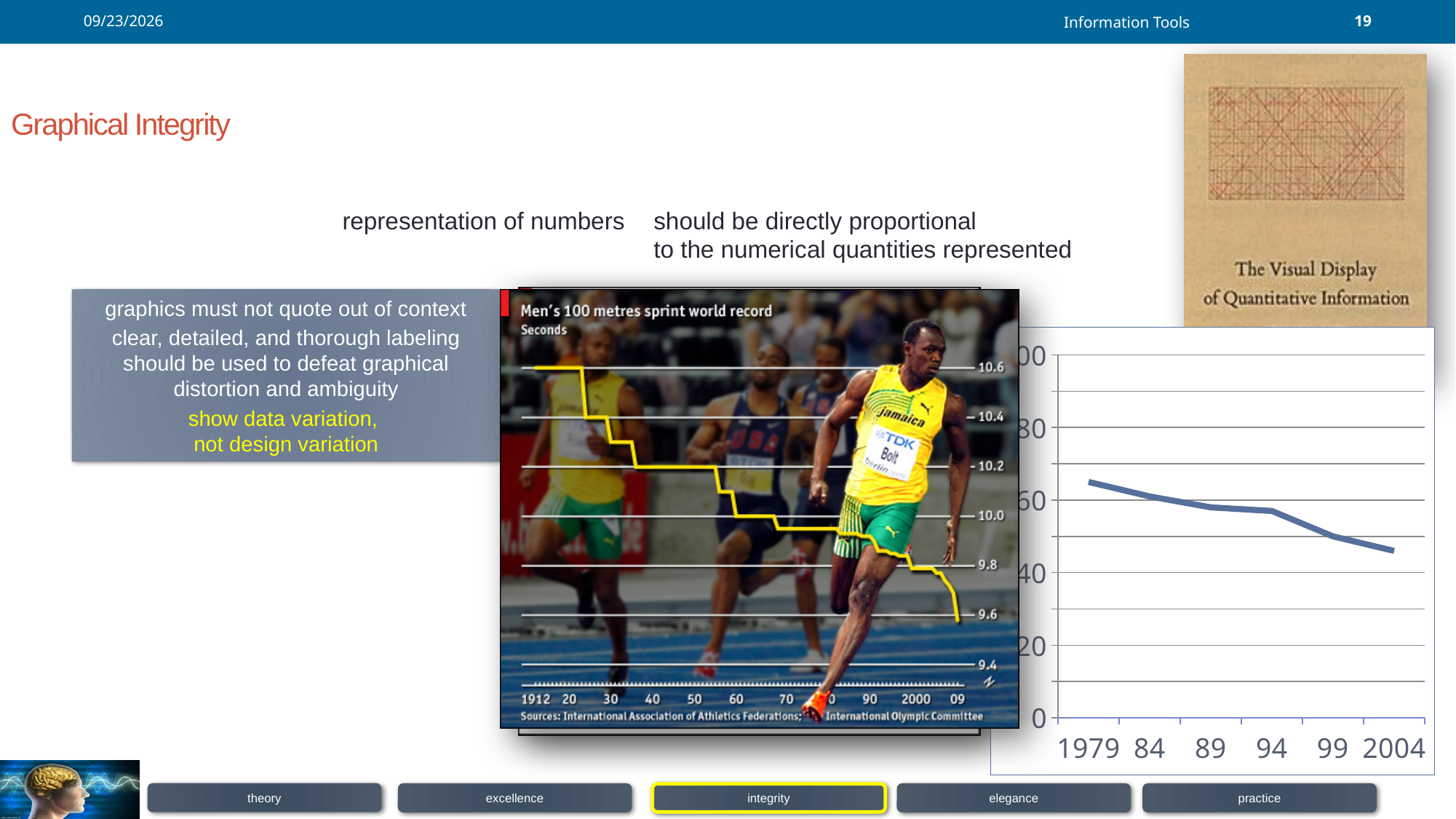
In the 'Men's 100 metres sprint world record' chart, is the value at 2009 greater or less than 9.8? less What kind of chart is the chart on the right side of the slide with years 1979 to 2004 on the x axis? line chart In the line chart on the right, is the value for 1979 greater or less than 60? greater In the line chart on the right, which year has the lowest value? 2004 How many year labels are shown on the x axis of the line chart on the right? 6 In the line chart on the right, is the value for 2004 greater or less than 40? greater In the line chart on the right, which year has the highest value? 1979 In the 'Men's 100 metres sprint world record' chart, what unit is shown on the y axis? Seconds What is the title of the chart overlaid on the photograph of the sprinters? Men's 100 metres sprint world record In the line chart on the right, which is larger, the value for 1979 or the value for 2004? 1979 In the line chart on the right (1979 to 2004), do the values rise or fall along the x axis? fall